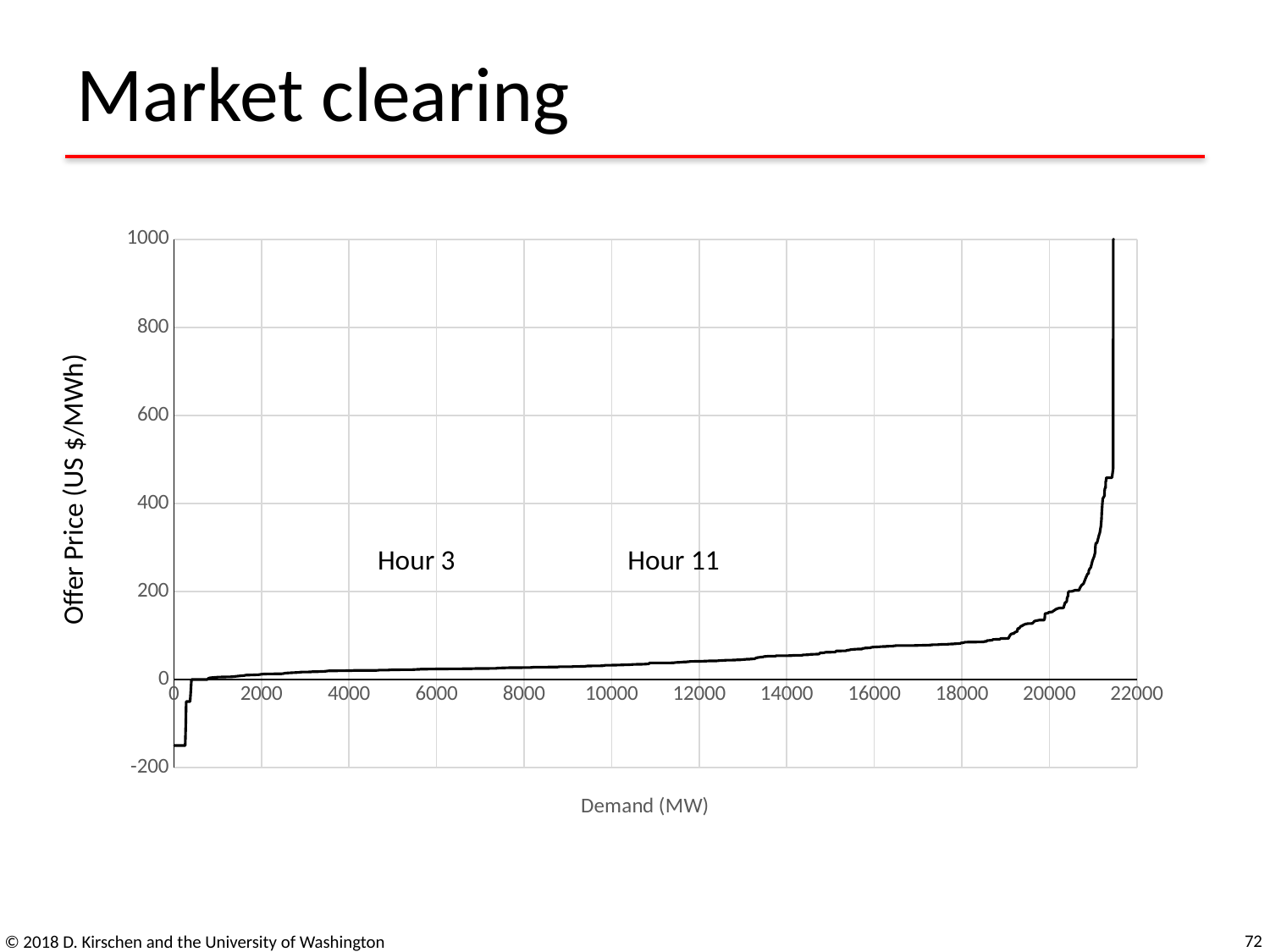
What is the label of the x axis? Demand (MW) Does the offer price generally rise or fall as demand increases along the x axis? rise Is the offer price at a demand of 4000 MW greater or less than 100 US $/MWh? less What is the label of the y axis? Offer Price (US $/MWh) Which is larger, the offer price at 20000 MW of demand or the offer price at 10000 MW of demand? 20000 MW Is the offer price at a demand of 16000 MW greater or less than 200 US $/MWh? less What kind of chart is shown on the slide? line chart Is the offer price at a demand of 10000 MW greater or less than 200 US $/MWh? less What is the highest value shown on the y axis? 1000